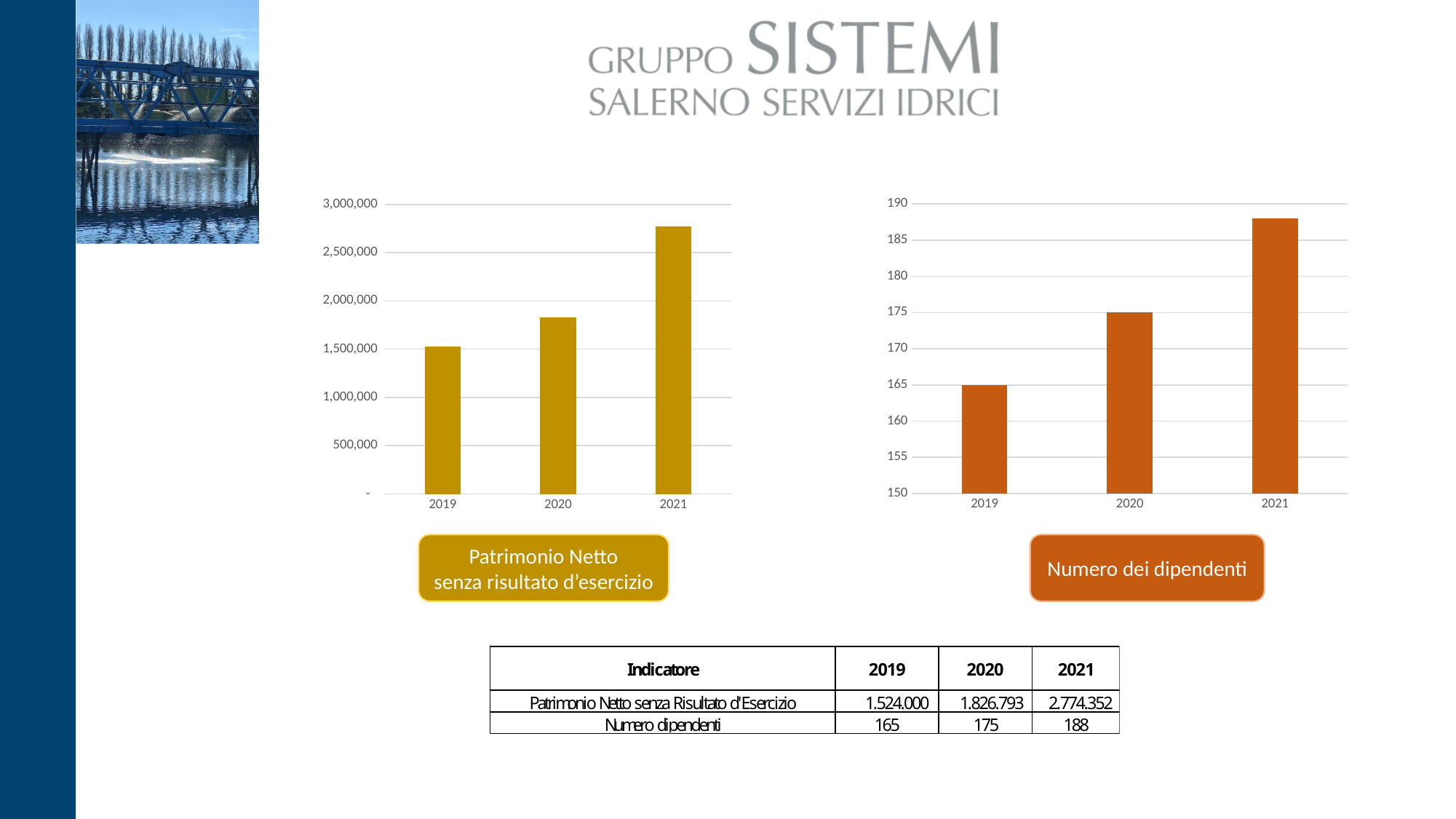
In the Patrimonio Netto senza risultato d'esercizio chart on the left, is the value for 2020 greater or less than 2,000,000? less How many years are shown on the x axis of the Patrimonio Netto senza risultato d'esercizio chart on the left? 3 In the Numero dei dipendenti chart on the right, what is the value for 2021? 188 What kind of chart is the Patrimonio Netto senza risultato d'esercizio chart on the left? bar chart In the Numero dei dipendenti chart on the right, do the values rise or fall from 2019 to 2021? rise In the Patrimonio Netto senza risultato d'esercizio chart on the left, is the value for 2021 greater or less than 2,500,000? greater In the Numero dei dipendenti chart on the right, which year has the highest value? 2021 In the Numero dei dipendenti chart on the right, what is the difference between the 2021 and 2019 values? 23 In the Patrimonio Netto senza risultato d'esercizio chart on the left, which year has the lowest value? 2019 In the Numero dei dipendenti chart on the right, what is the value for 2020? 175 In the Numero dei dipendenti chart on the right, what is the value for 2019? 165 In the Patrimonio Netto senza risultato d'esercizio chart on the left, what is the value for 2021? 2.774.352